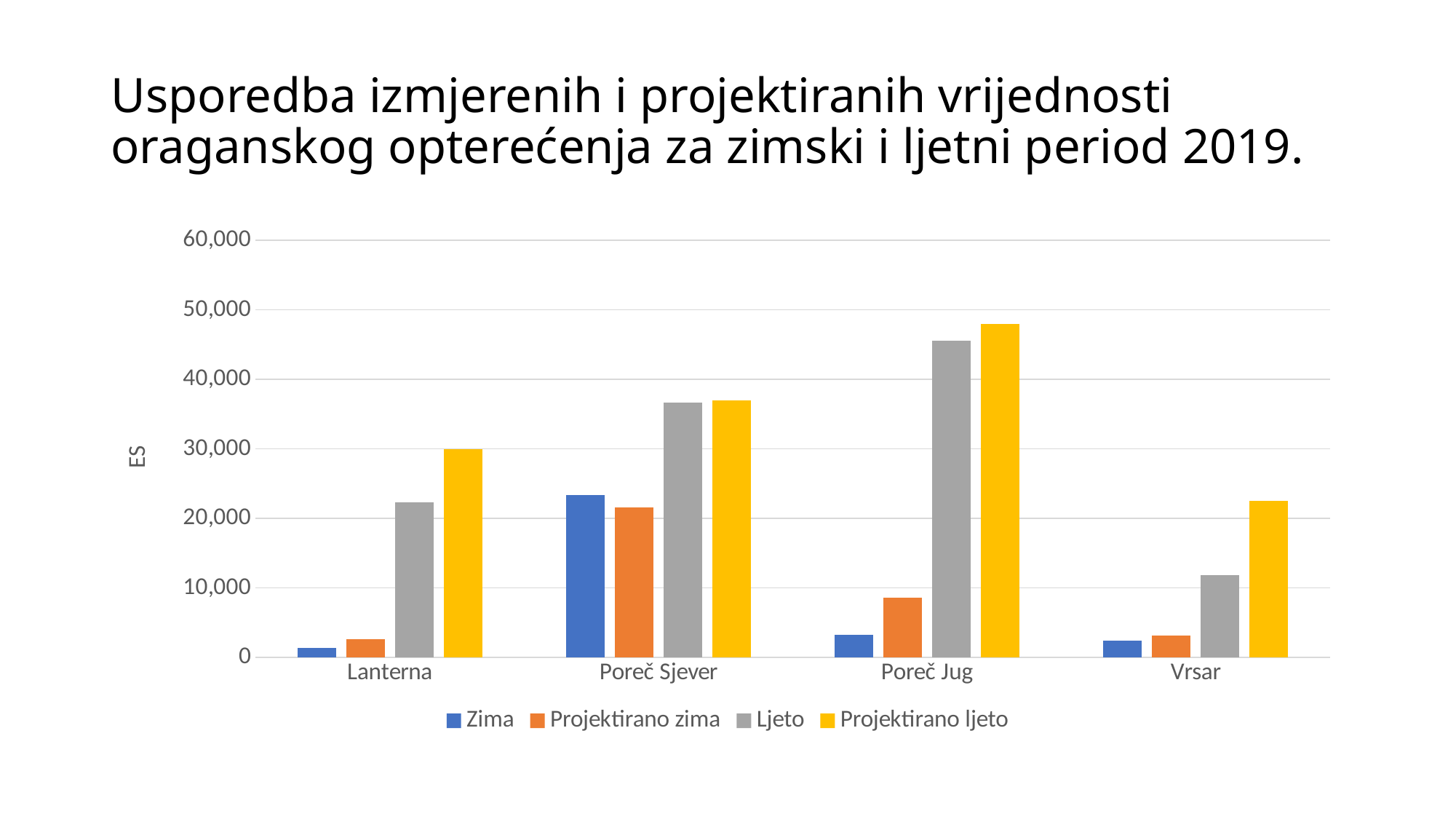
Which category has the highest value for Zima? Poreč Sjever Which category has the lowest value for Ljeto? Vrsar What kind of chart is shown on the slide? bar chart Which category has the highest value for Projektirano ljeto? Poreč Jug What is the label on the vertical axis? ES For Poreč Jug, which is larger: Zima or Projektirano zima? Projektirano zima How many categories are shown on the x axis? 4 Is the Projektirano ljeto value for Vrsar greater or less than 20,000? greater How many series does the legend list? 4 Which has the larger Ljeto value: Lanterna or Vrsar? Lanterna Is the Zima value for Lanterna greater or less than 10,000? less Is the Ljeto value for Poreč Jug greater or less than 40,000? greater